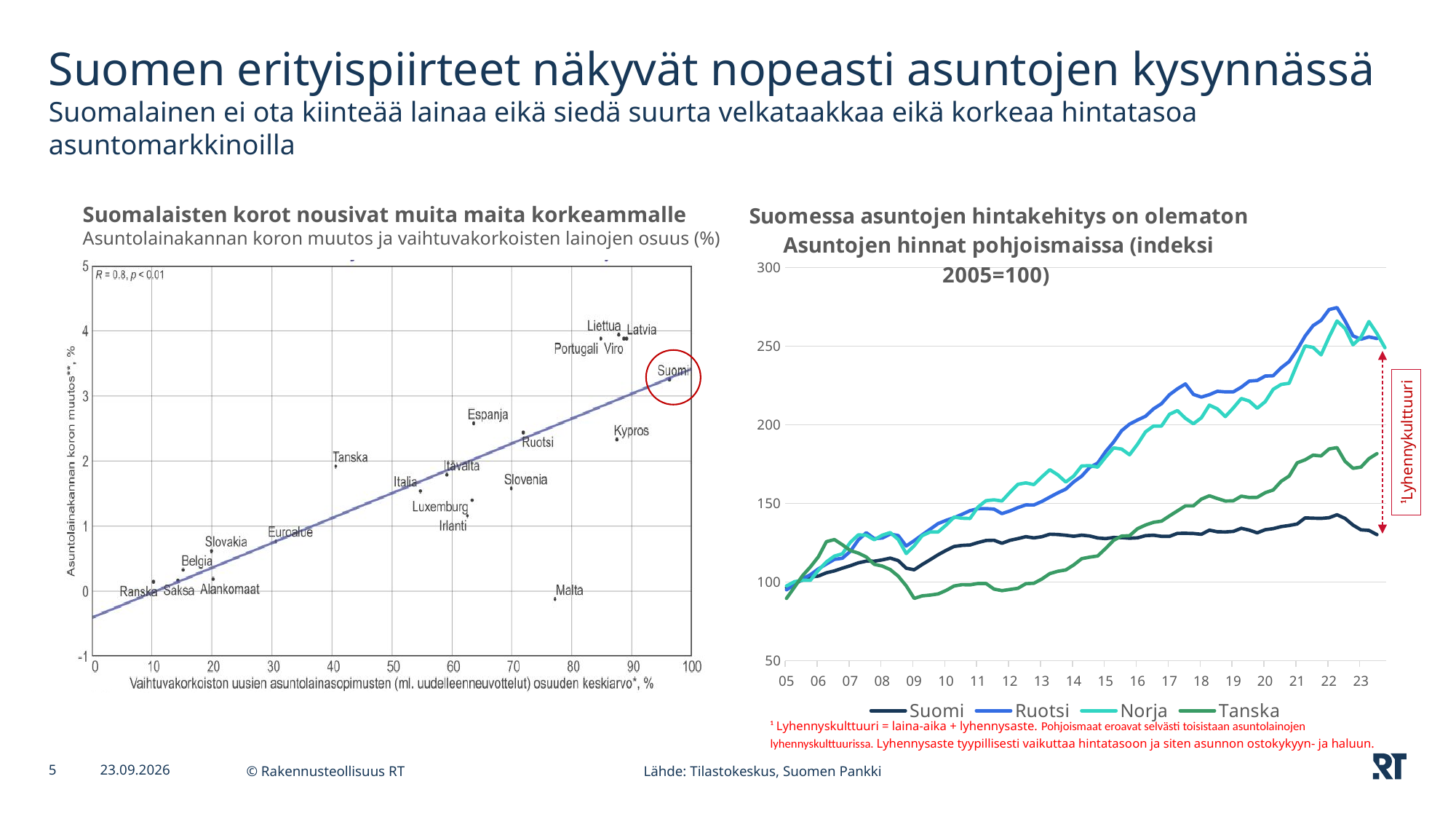
In the right chart (Asuntojen hinnat pohjoismaissa), does the Suomi series generally rise or fall from 2005 to 2023? Rise In the right chart, what base year and value does the index use according to the chart title? 2005=100 In the left scatter plot, which country has the lowest value on the vertical axis (Asuntolainakannan koron muutos)? Malta In the right chart (Asuntojen hinnat pohjoismaissa), which series has the lowest value at the end of the period (2023)? Suomi What kind of chart is the right chart titled "Suomessa asuntojen hintakehitys on olematon"? Line chart What kind of chart is the left chart titled "Suomalaisten korot nousivat muita maita korkeammalle"? Scatter plot In the left scatter plot, is the horizontal-axis value for Suomi greater or less than 90? greater In the right chart (Asuntojen hinnat pohjoismaissa), is the value for Tanska at the end of 2023 greater or less than 200? less In the right chart (Asuntojen hinnat pohjoismaissa), is the value for Suomi at the end of 2023 greater or less than 150? less In the right chart (Asuntojen hinnat pohjoismaissa), how many series does the legend list? 4 In the right chart (Asuntojen hinnat pohjoismaissa), which is larger in 2022: Ruotsi or Suomi? Ruotsi